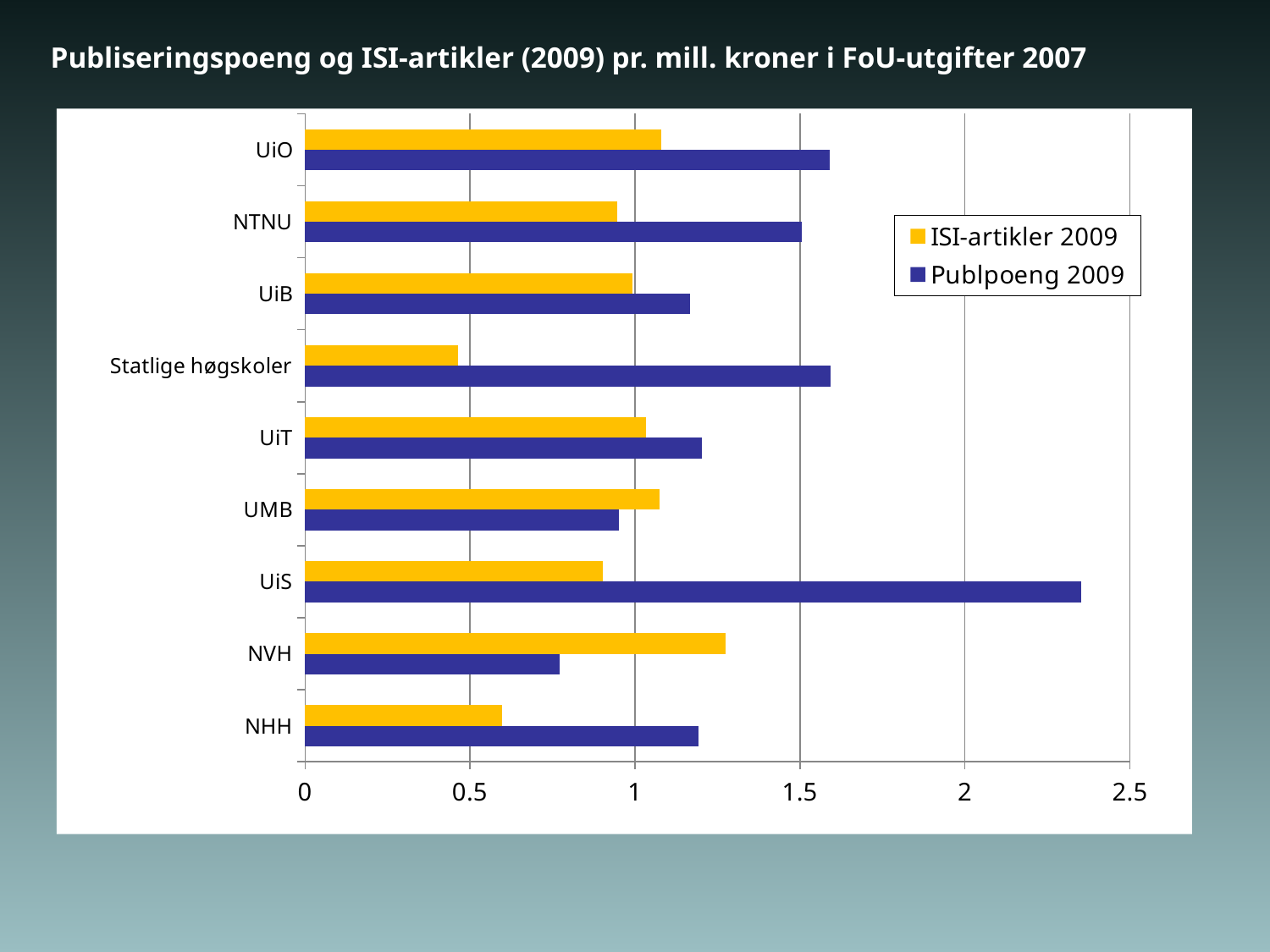
How many series does the legend list? 2 Which institution has the highest Publpoeng 2009 value? UiS Is the Publpoeng 2009 value for NVH greater or less than 1? less What kind of chart is shown on the slide? bar chart How many institutions (categories) are shown on the chart? 9 Which institution has the highest ISI-artikler 2009 value? NVH Is the Publpoeng 2009 value for UiS greater or less than 2? greater Is the ISI-artikler 2009 value for Statlige høgskoler greater or less than 0.5? less Which institution has the lowest Publpoeng 2009 value? NVH For NVH, which is larger: ISI-artikler 2009 or Publpoeng 2009? ISI-artikler 2009 Which colour represents Publpoeng 2009 in the legend? blue Which institution has the lowest ISI-artikler 2009 value? Statlige høgskoler